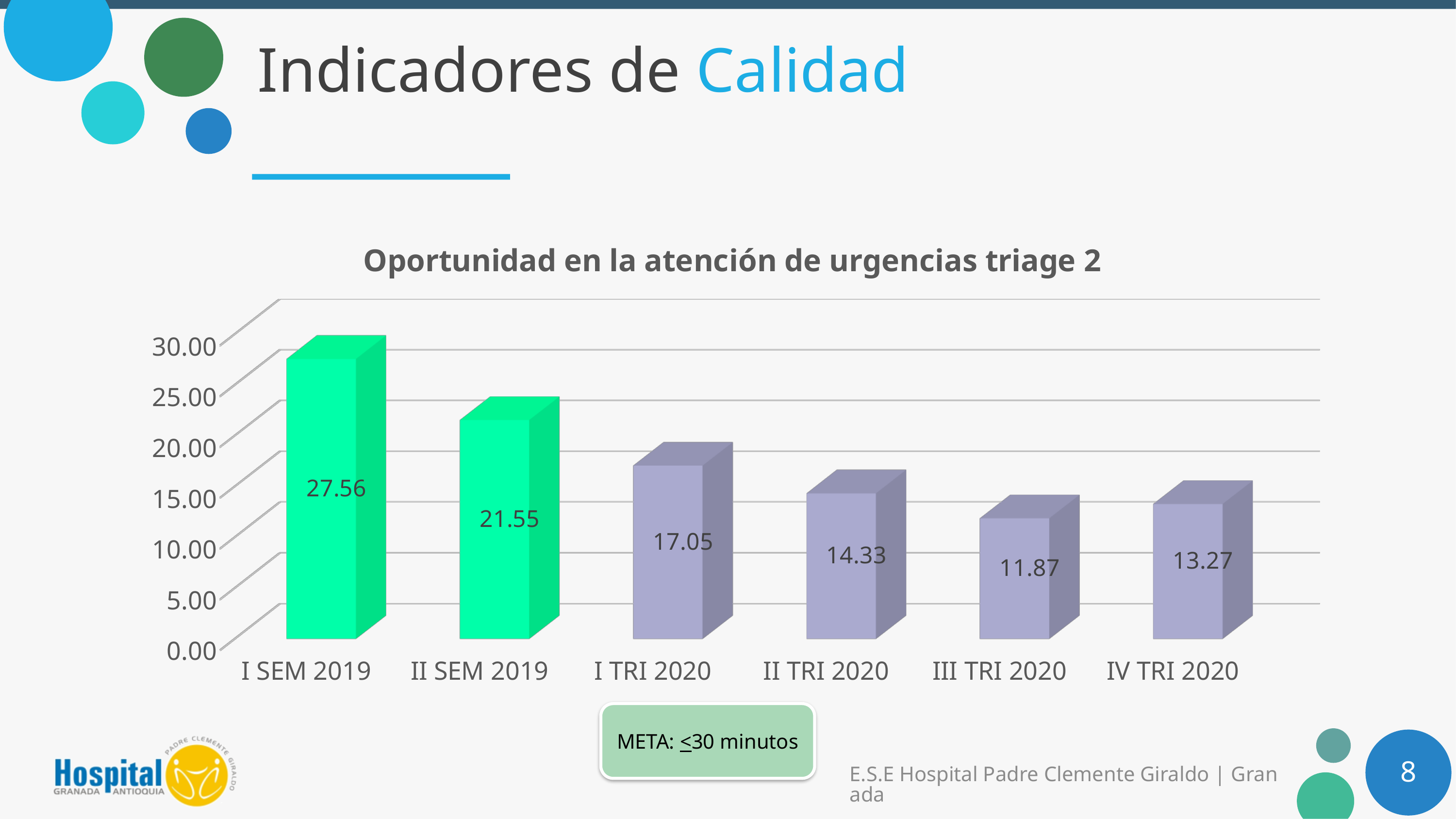
What is the difference between the values for I TRI 2020 and II TRI 2020? 2.72 What kind of chart is shown? bar chart What is the value for IV TRI 2020? 13.27 What is the value for III TRI 2020? 11.87 What is the difference between the values for I SEM 2019 and II SEM 2019? 6.01 Which category has the lowest value? III TRI 2020 Which category has the highest value? I SEM 2019 What is the title of the chart? Oportunidad en la atención de urgencias triage 2 How many categories are shown on the x axis? 6 What is the value for I SEM 2019? 27.56 Which is larger, the value for II TRI 2020 or the value for IV TRI 2020? II TRI 2020 Do the values generally rise or fall from I SEM 2019 to III TRI 2020? fall